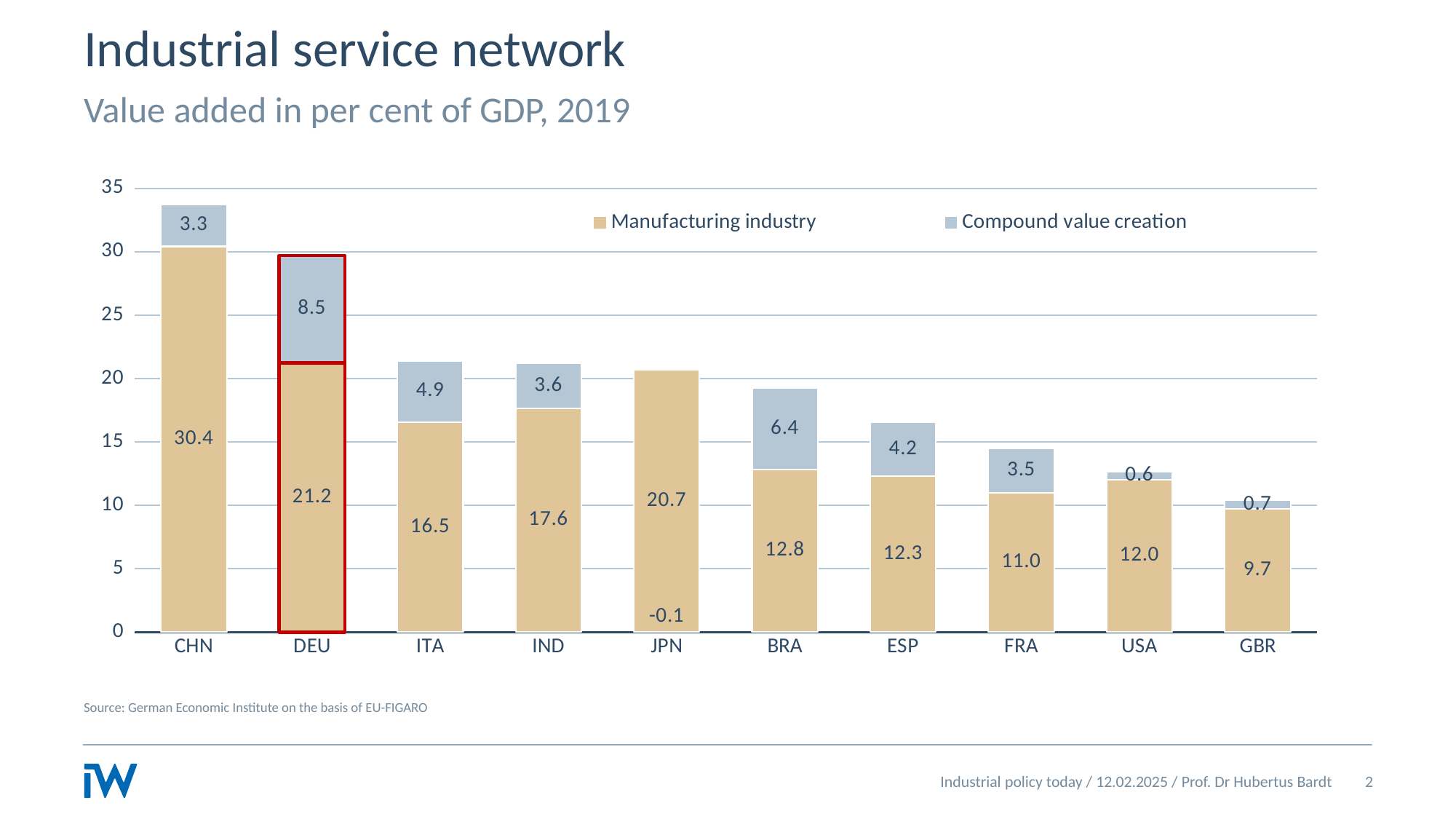
How many countries are shown on the x axis? 10 What is the Compound value creation value for BRA? 6.4 How many series does the legend list? 2 Which country has the highest Compound value creation value? DEU What is the Manufacturing industry value for JPN? 20.7 Which country has the highest Manufacturing industry value? CHN Which is larger, the Manufacturing industry value for ITA or for IND? IND Which country has the lowest Compound value creation value? JPN What is the total of the stacked bar for FRA? 14.5 What is the difference between the Manufacturing industry values for CHN and DEU? 9.2 What is the Manufacturing industry value for DEU? 21.2 What kind of chart is shown on the slide? Stacked bar chart